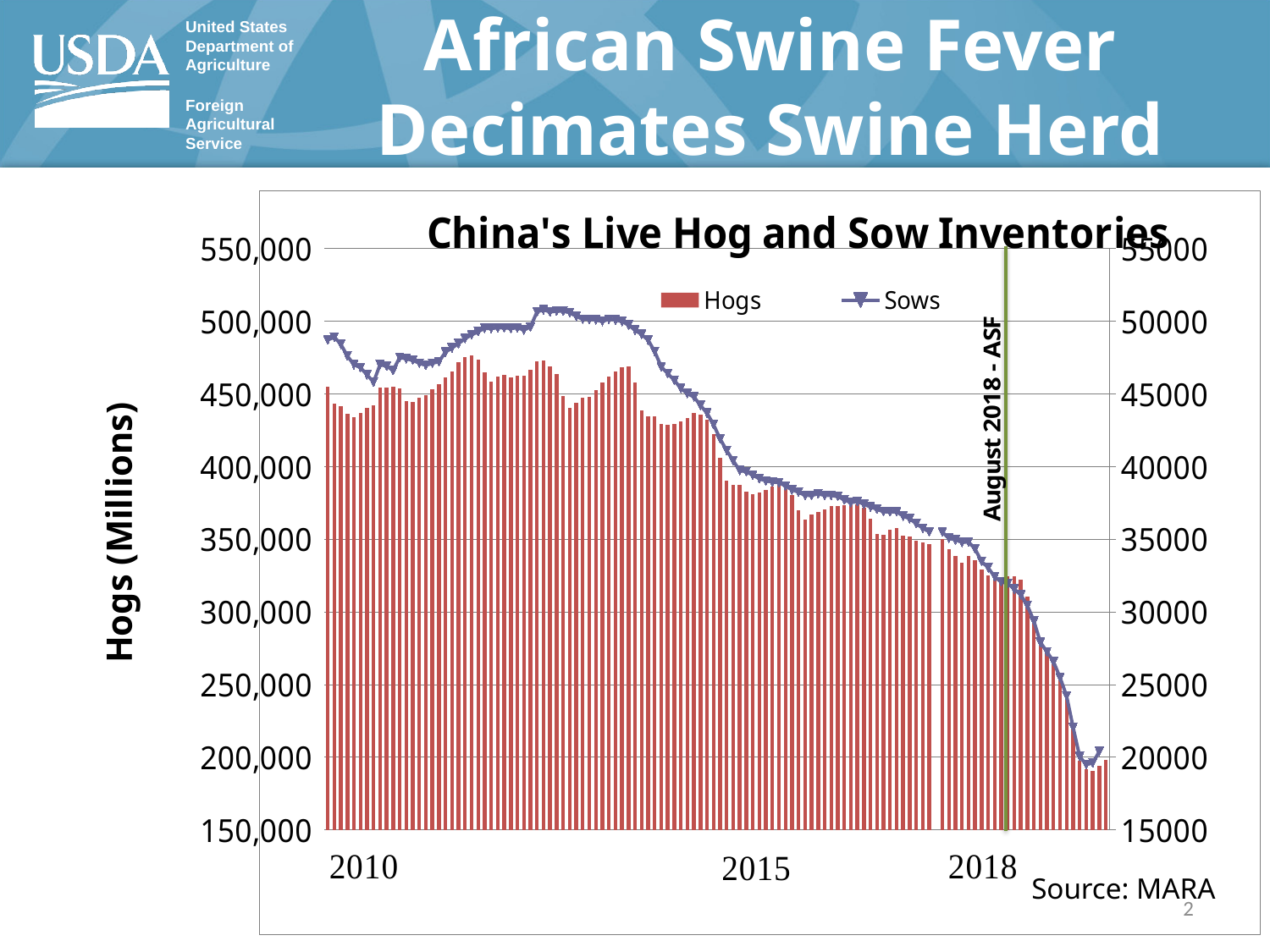
Is the Hogs value at the far right end of the chart greater or less than 250,000? less Do the Sows values rise or fall between 2015 and the end of the chart? fall Is the Sows value at the far right end of the chart greater or less than 25000 on the right axis? less Do the Hogs values rise or fall after the August 2018 ASF line? fall Is the Hogs value at the start of 2010 greater or less than 400,000? greater Which series in the chart is drawn as bars? Hogs How many series does the legend of the chart list? 2 What kind of chart is used to show China's Live Hog and Sow Inventories? Combined bar and line chart What is the title of the chart? China's Live Hog and Sow Inventories